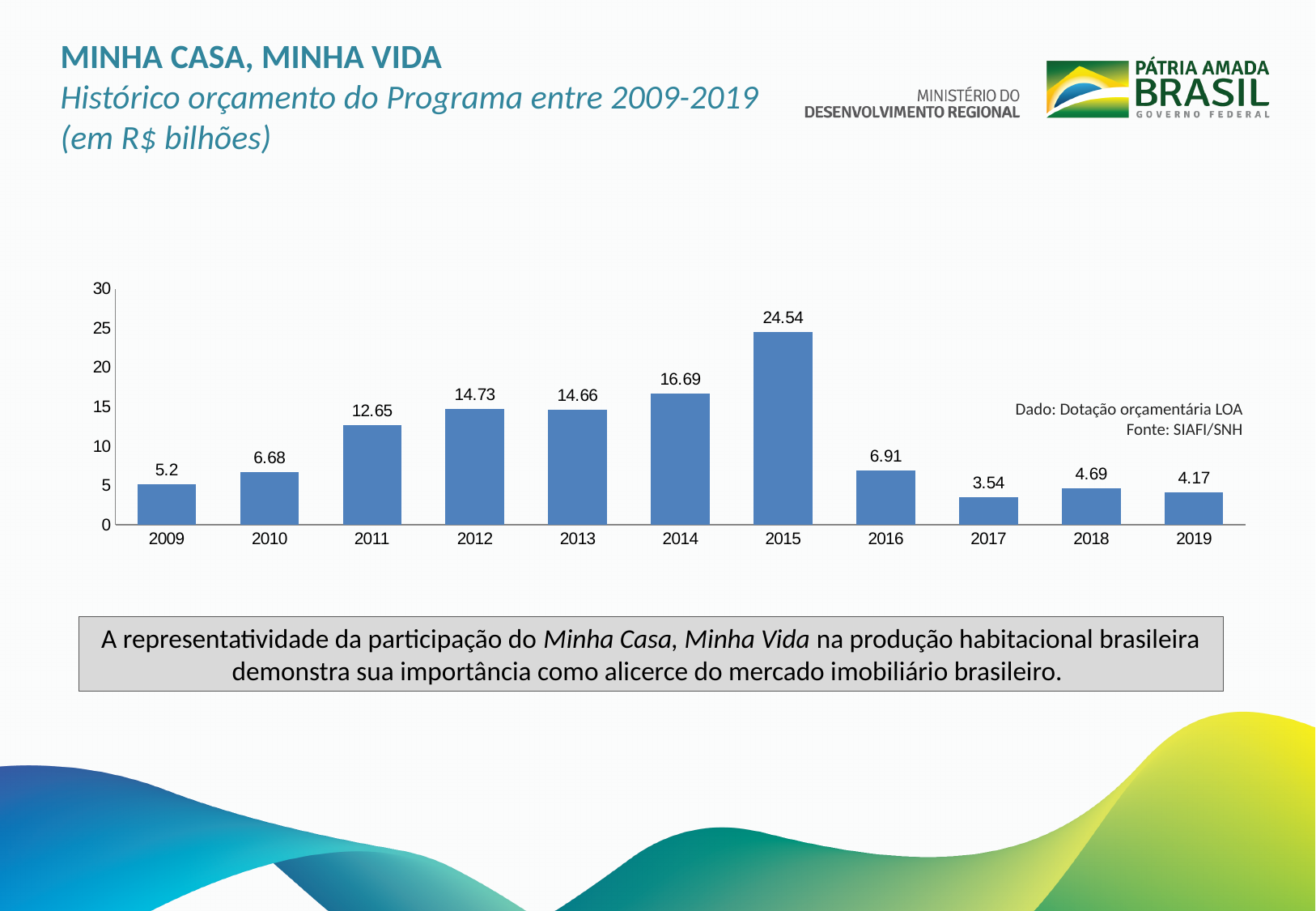
What is the value for 2019? 4.17 Which year has the lowest value? 2017 Which is larger, the value for 2010 or the value for 2016? 2016 Is the value for 2014 greater or less than 15? greater What kind of chart is shown on the slide? Bar chart What is the difference between the values for 2012 and 2013? 0.07 How many years are shown on the x axis? 11 What is the value for 2009? 5.2 Which year has the highest value? 2015 Do the values rise or fall from 2015 to 2017? Fall What is the difference between the values for 2015 and 2016? 17.63 What is the value for 2015? 24.54